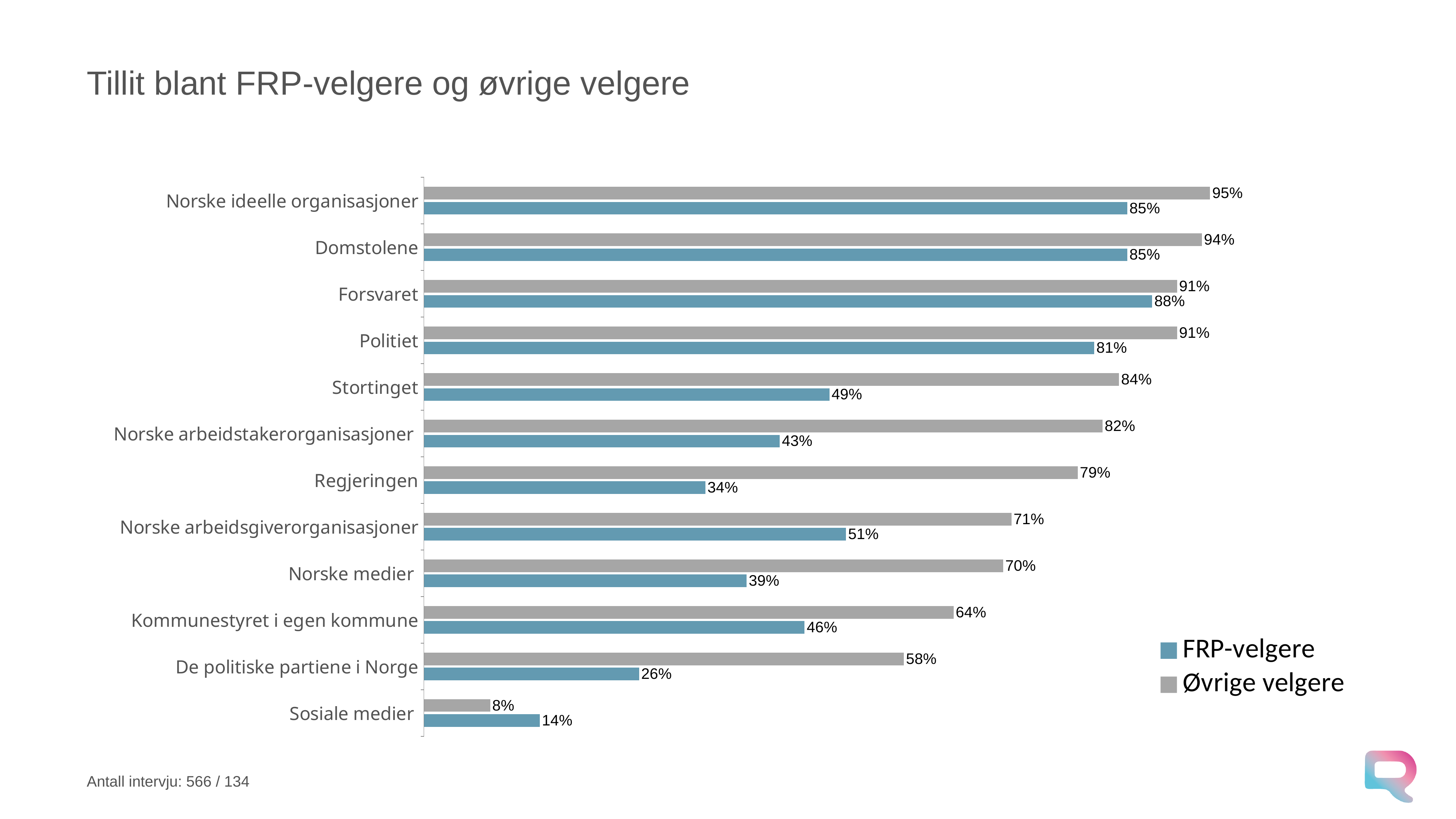
How many categories are shown on the chart? 12 How many series does the legend list? 2 For Sosiale medier, which series has the larger value, FRP-velgere or Øvrige velgere? FRP-velgere What is the value for FRP-velgere for Stortinget? 49% What kind of chart is shown on the slide? Bar chart What is the title of the chart on the slide? Tillit blant FRP-velgere og øvrige velgere What is the difference between Øvrige velgere and FRP-velgere for Regjeringen? 45% What is the value for FRP-velgere for Sosiale medier? 14% What is the difference between Øvrige velgere and FRP-velgere for Stortinget? 35% Which category has the lowest value for FRP-velgere? Sosiale medier What is the value for Øvrige velgere for Regjeringen? 79% Which category has the highest value for Øvrige velgere? Norske ideelle organisasjoner